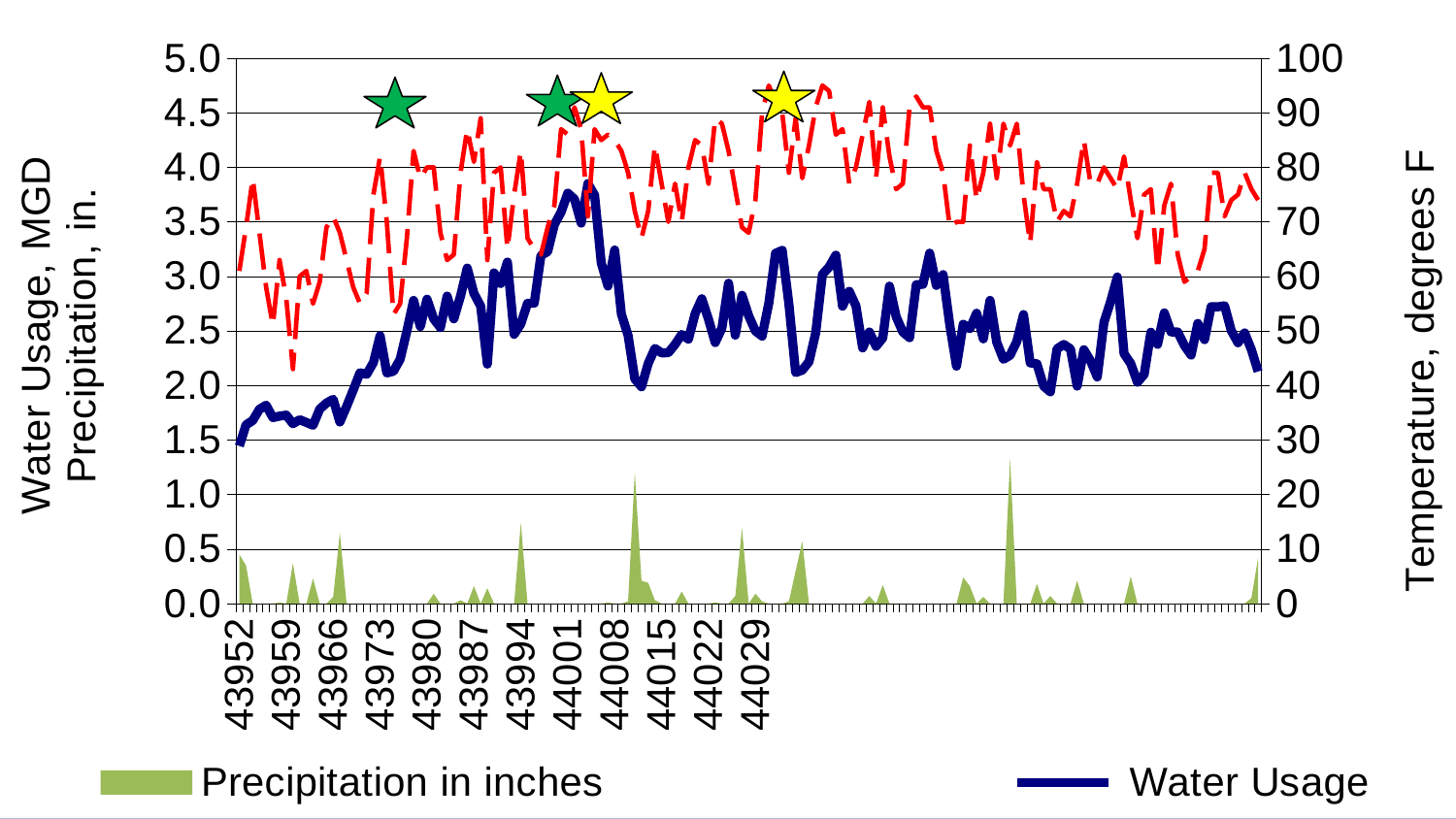
How many labels are printed along the x axis? 12 What kind of chart is shown on the slide? A combination chart with an area series and line series What is the highest tick value on the left vertical axis? 5.0 What are the two entries in the legend? Precipitation in inches and Water Usage What is the first x-axis label? 43952 Is the Water Usage value at 43952 greater or less than 2.0? less Is the highest Precipitation in inches value on the chart greater or less than 1.0? greater What is the highest tick value on the right vertical axis? 100 Is the highest Water Usage value on the chart greater or less than 4.0? less What is the title of the right-hand vertical axis? Temperature, degrees F How many series does the legend list? 2 Does Water Usage generally rise or fall between 43952 and 44001? rise